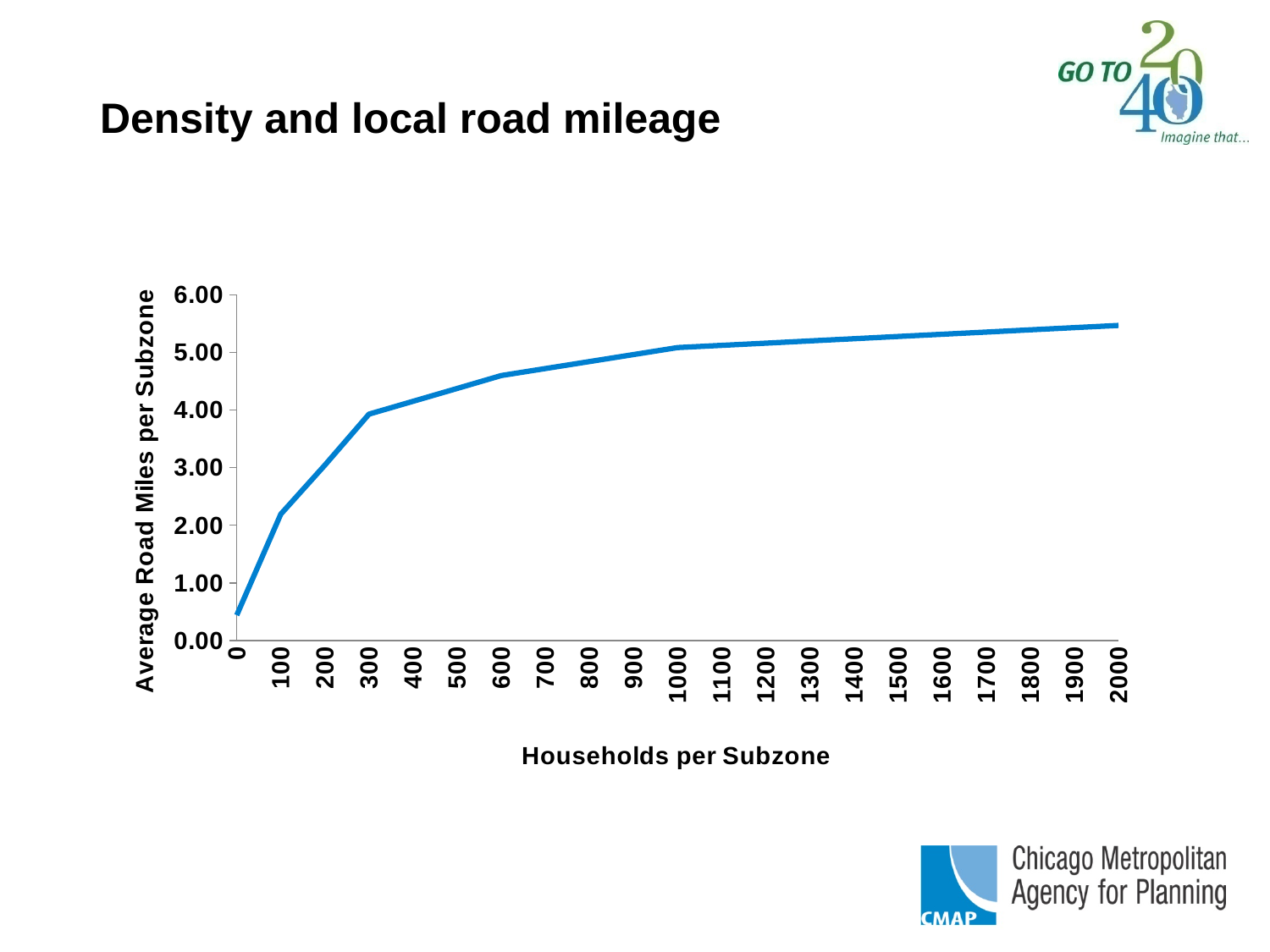
Is the value for 2000 households per subzone greater or less than 5.00? greater At which households-per-subzone value is the average road miles per subzone highest? 2000 Is the value for 100 households per subzone greater or less than 3.00? less Which is larger, the value at 100 households per subzone or the value at 1000 households per subzone? 1000 households per subzone At which households-per-subzone value is the average road miles per subzone lowest? 0 Do the values rise or fall as households per subzone increase along the x axis? rise Is the value for 600 households per subzone greater or less than 4.00? greater What kind of chart is shown on the slide? line chart What is the title of the y axis? Average Road Miles per Subzone